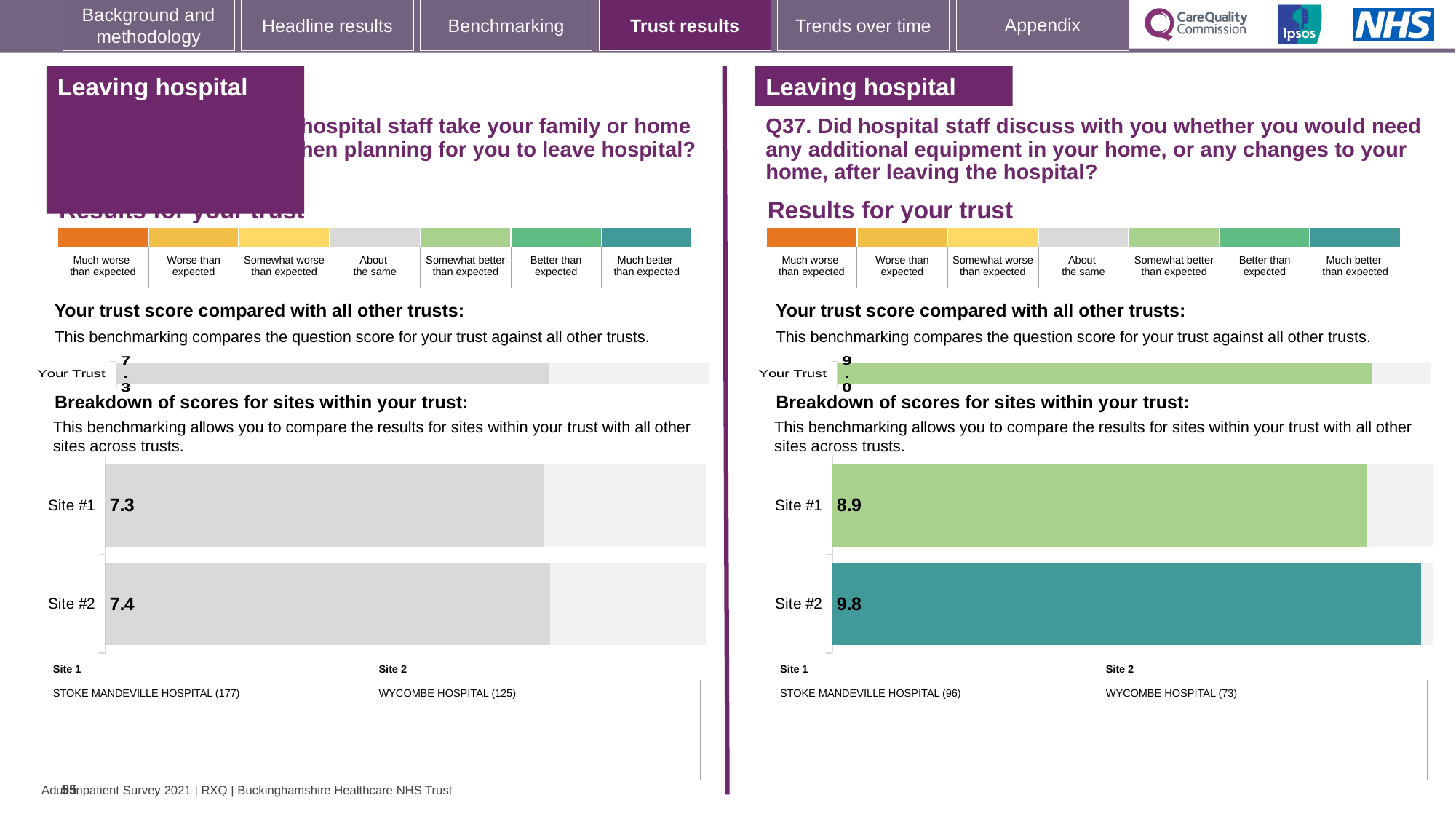
How many sites are shown in the right-hand (Q37) site breakdown chart? 2 In the left-hand site breakdown chart, what is the difference between the Site #2 and Site #1 scores? 0.1 In the right-hand (Q37) site breakdown chart, which site's bar is coloured teal (the 'Much better than expected' colour)? Site #2 In the right-hand (Q37) 'Your trust score compared with all other trusts' chart, what is the score shown for Your Trust? 9.0 In the left-hand site breakdown chart, what is the score for Site #1? 7.3 In the right-hand (Q37) site breakdown chart, what is the difference between the Site #2 and Site #1 scores? 0.9 In the right-hand (Q37) site breakdown chart, what is the score for Site #2? 9.8 In the left-hand 'Your trust score compared with all other trusts' chart, what is the score shown for Your Trust? 7.3 In the right-hand (Q37) site breakdown chart, what is the score for Site #1? 8.9 In the left-hand site breakdown chart, what is the score for Site #2? 7.4 In the right-hand (Q37) site breakdown chart, which site has the higher score? Site #2 What type of chart is used for the site breakdown on the right-hand (Q37) side? Bar chart